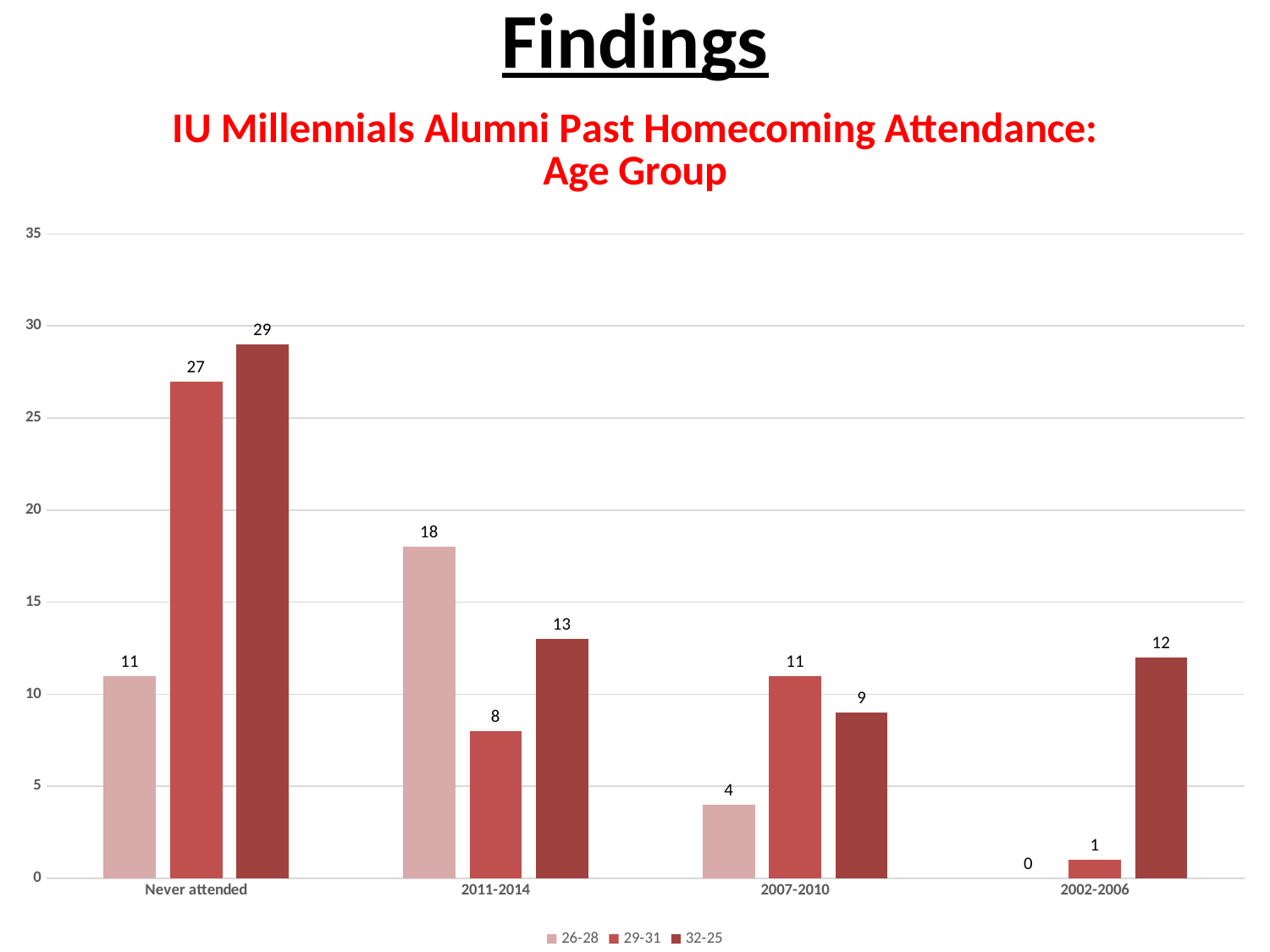
How many categories are shown on the x axis? 4 How many series does the legend list? 3 Which category has the highest value for the 29-31 series? Never attended What is the value for the 29-31 series in the 2002-2006 category? 1 What kind of chart is shown on the slide? Bar chart What is the value for the 26-28 series in the 2011-2014 category? 18 What is the title of the chart? IU Millennials Alumni Past Homecoming Attendance: Age Group What is the difference between the 32-25 and 29-31 values in the 2011-2014 category? 5 Which category has the lowest value for the 26-28 series? 2002-2006 What is the total of the three series values in the 2007-2010 category? 24 What is the value for the 32-25 series in the Never attended category? 29 Which is larger in the 2007-2010 category: the 29-31 value or the 32-25 value? 29-31